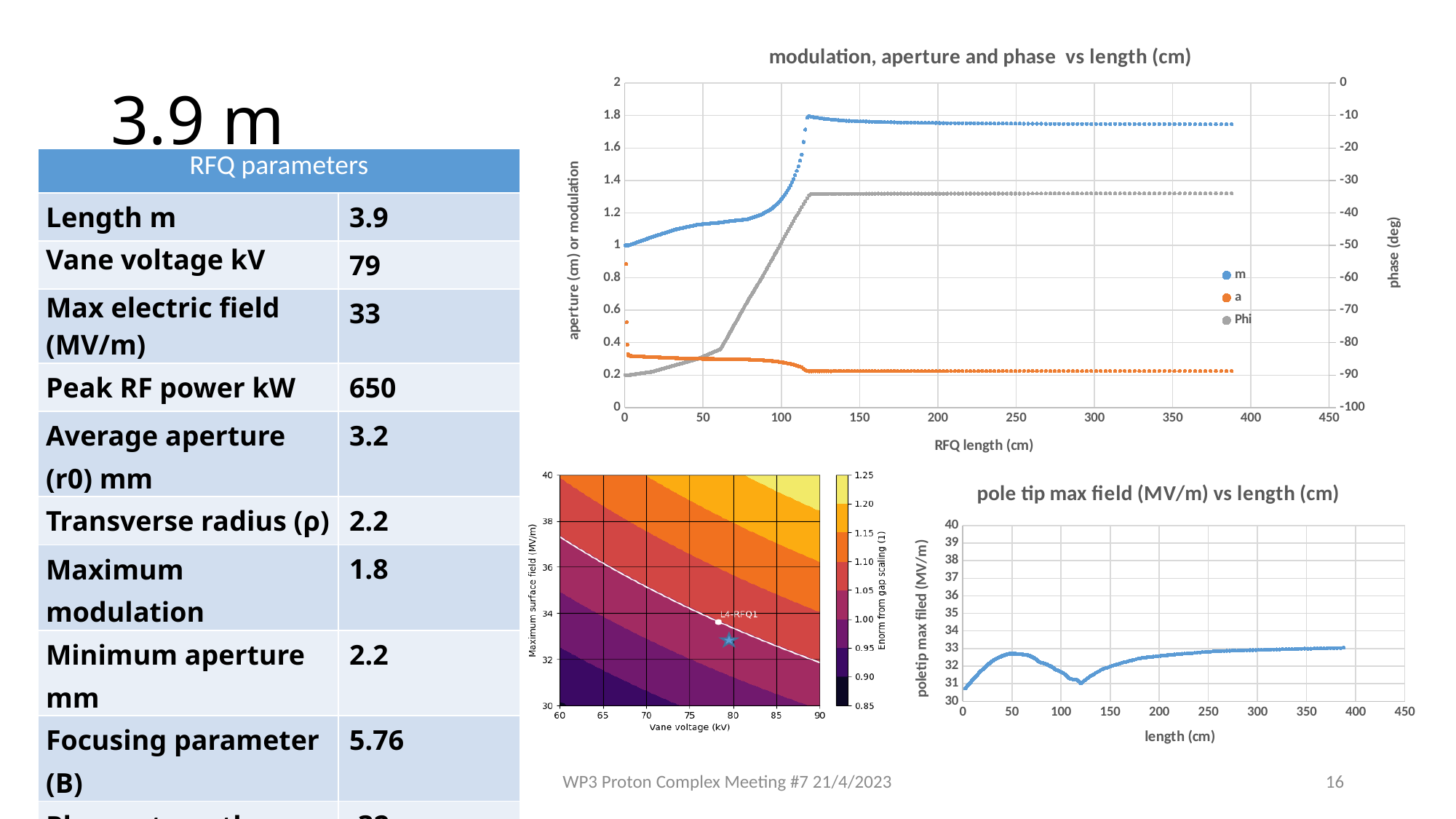
In the chart titled 'modulation, aperture and phase vs length (cm)', is the value of the a series at an RFQ length of 300 cm greater or less than 0.4? less In the chart titled 'modulation, aperture and phase vs length (cm)', is the value of the m series at an RFQ length of 200 cm greater or less than 1.6? greater In the chart titled 'modulation, aperture and phase vs length (cm)', what are the three legend entries? m, a, Phi In the chart titled 'modulation, aperture and phase vs length (cm)', does the a series rise or fall as RFQ length increases from 0 to 120 cm? fall In the chart titled 'pole tip max field (MV/m) vs length (cm)', which is larger: the value at 50 cm or the value at 120 cm? the value at 50 cm In the chart titled 'modulation, aperture and phase vs length (cm)', does the m series rise or fall as RFQ length increases from 0 to 120 cm? rise What is the label of the right-hand vertical axis in the chart titled 'modulation, aperture and phase vs length (cm)'? phase (deg) How many series does the legend of the chart titled 'modulation, aperture and phase vs length (cm)' list? 3 In the chart titled 'pole tip max field (MV/m) vs length (cm)', is the value at a length of 120 cm greater or less than 32? less In the chart titled 'modulation, aperture and phase vs length (cm)', which series has the higher value at an RFQ length of 300 cm on the left axis, m or a? m In the chart titled 'pole tip max field (MV/m) vs length (cm)', does the value rise or fall as length increases from 150 cm to 350 cm? rise